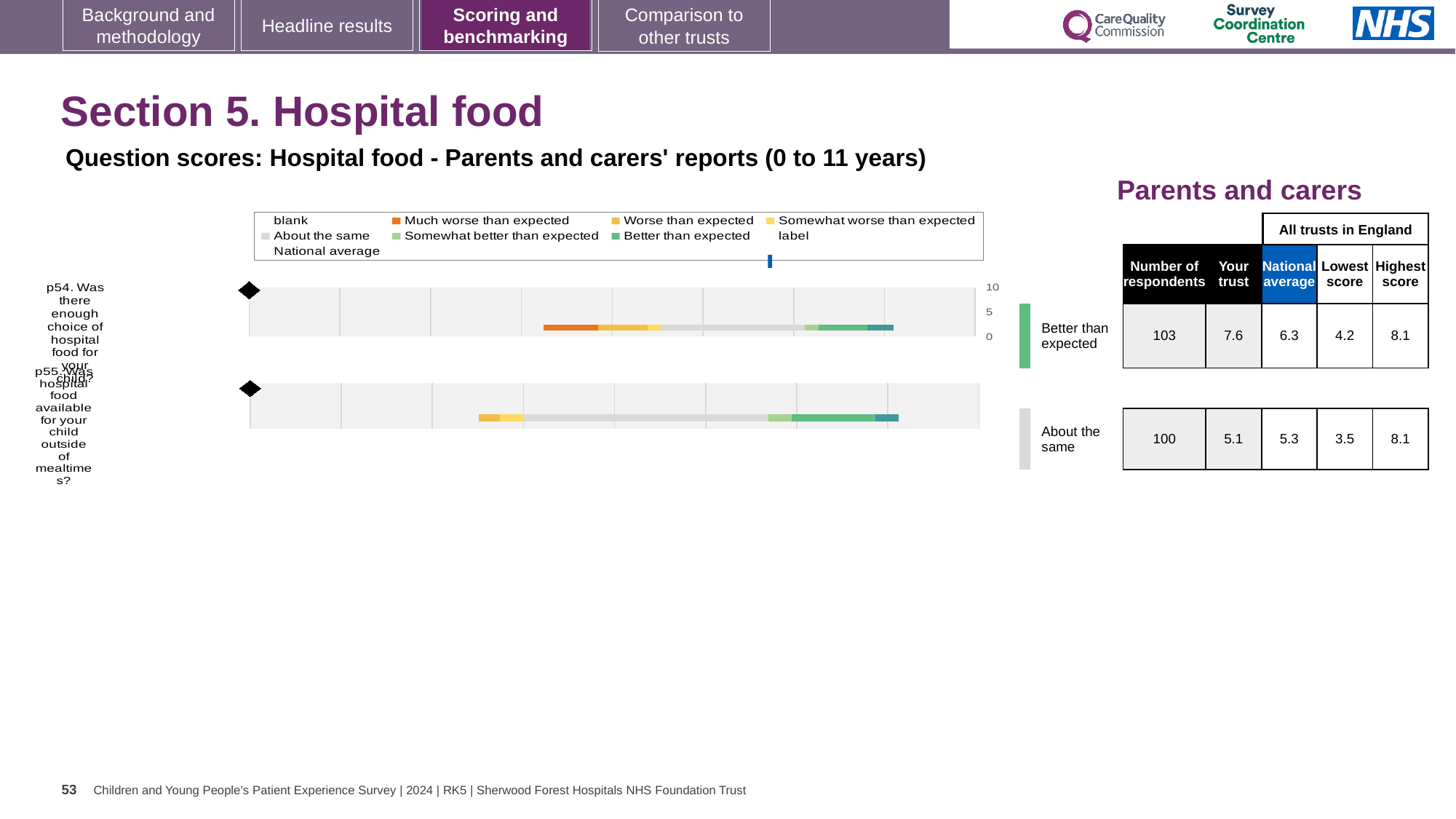
What is the national average score for p55 (hospital food available outside of mealtimes)? 5.3 How many survey questions (bars) are plotted in the chart? 2 What is the difference between the 'Your trust' score and the national average for p54? 1.3 What is the 'Your trust' score for p54 (enough choice of hospital food)? 7.6 What is the maximum value shown on the chart's score axis? 10 What is the lowest score among all trusts in England for p54? 4.2 How many respondents answered p54? 103 Which benchmark category is the trust's result for p54 placed in? Better than expected Which survey question is plotted in the top bar of the chart? p54 What kind of chart is shown on the slide? bar chart For p54, is the 'Your trust' score higher or lower than the national average? higher What is the highest score among all trusts in England for p55? 8.1